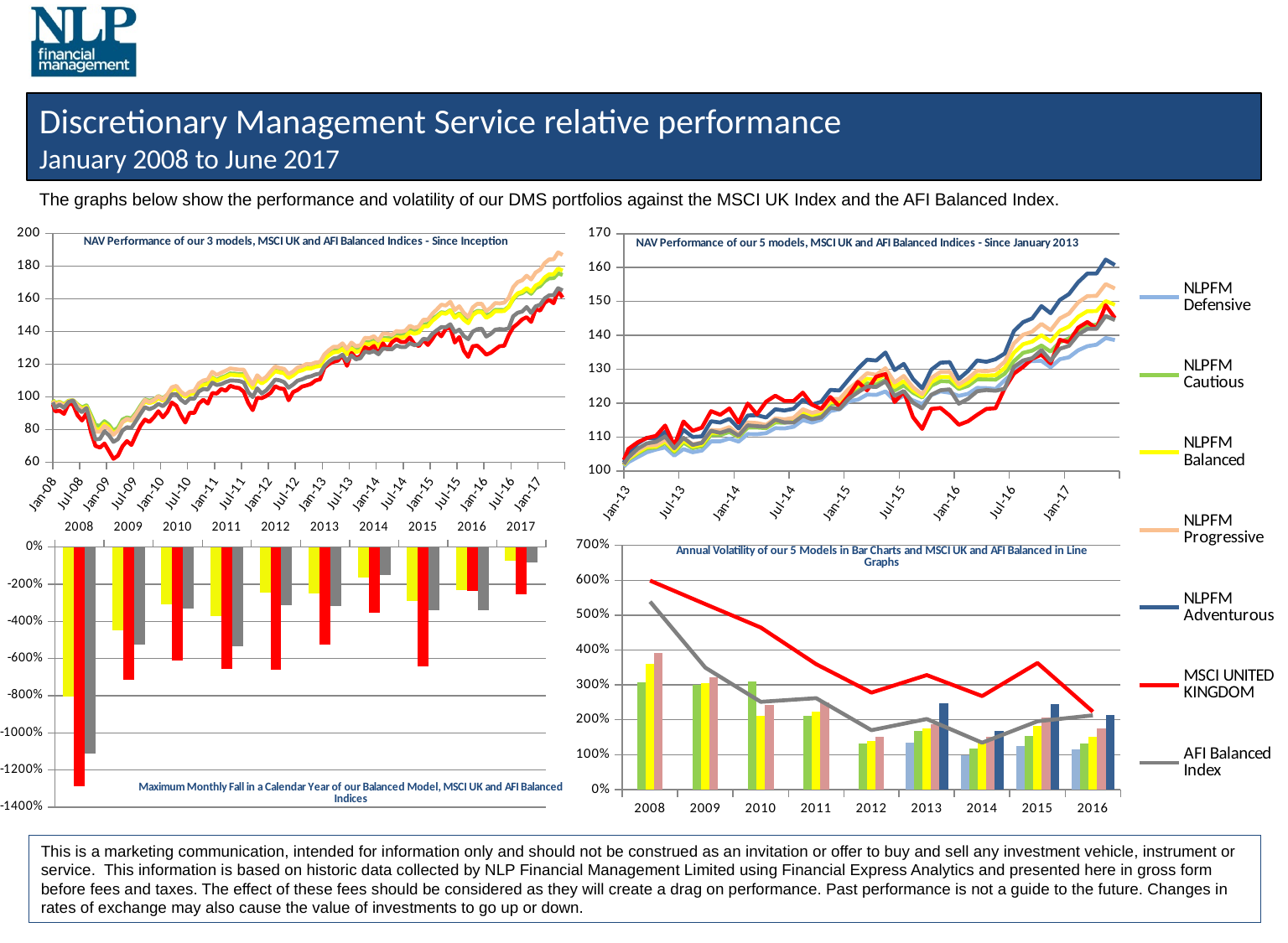
What kind of chart is the 'Maximum Monthly Fall in a Calendar Year of our Balanced Model, MSCI UK and AFI Balanced Indices' chart? bar chart In the 'NAV Performance of our 5 models ... Since January 2013' chart, which series finishes highest at the end of the period? NLPFM Adventurous How many series does the shared legend on the right of the slide list? 7 In the 'Annual Volatility of our 5 Models' chart, how many years are shown on the x axis? 9 In the 'Maximum Monthly Fall in a Calendar Year' chart, is the 2008 value for MSCI United Kingdom greater or less than -1200%? less Which colour represents MSCI United Kingdom in the legend? red In the 'Annual Volatility of our 5 Models' chart, is the 2008 value of the MSCI United Kingdom line greater or less than 500%? greater In the 'Maximum Monthly Fall in a Calendar Year' chart, which year shows the largest fall for MSCI United Kingdom? 2008 In the 'Annual Volatility of our 5 Models' chart, does the MSCI United Kingdom line generally rise or fall from 2008 to 2016? fall In the 'Maximum Monthly Fall in a Calendar Year' chart, how many calendar years are shown on the x axis? 10 What kind of chart is the 'NAV Performance of our 3 models, MSCI UK and AFI Balanced Indices - Since Inception' chart? line chart In the 'NAV Performance of our 3 models ... Since Inception' chart, is the MSCI United Kingdom value around Jan-09 greater or less than 80? less